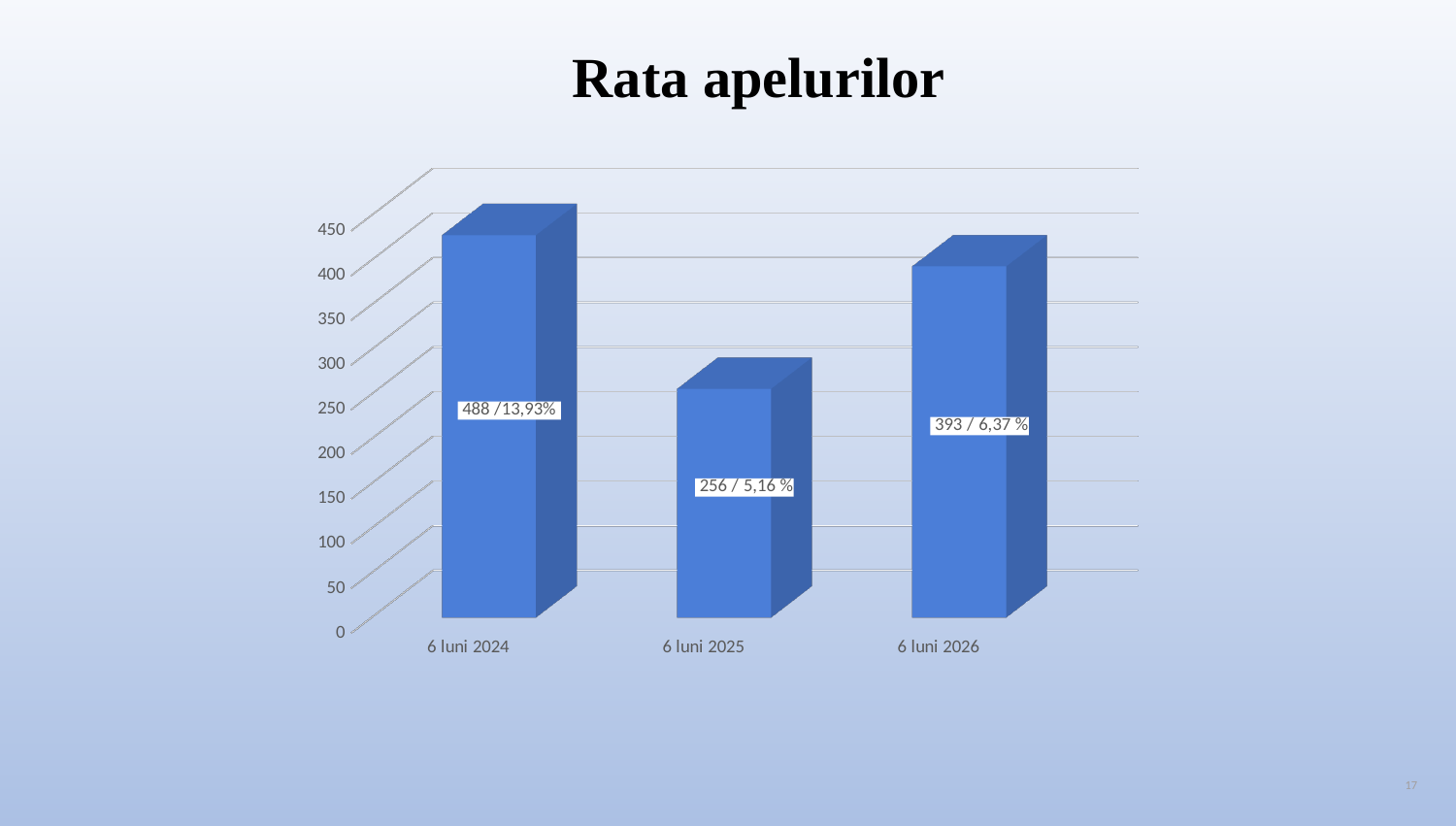
Which category has the lowest bar? 6 luni 2025 How many categories are shown on the x axis? 3 What kind of chart is shown on the slide? bar chart Is the value for 6 luni 2025 greater or less than 300? less What is the data label shown for 6 luni 2026? 393 / 6,37 % What is the title of the chart? Rata apelurilor Which category has the highest bar? 6 luni 2024 What is the difference between the count for 6 luni 2024 (488) and the count for 6 luni 2025 (256)? 232 Which is larger, the value for 6 luni 2026 or the value for 6 luni 2025? 6 luni 2026 What is the data label shown for 6 luni 2024? 488 /13,93% What is the difference between the count for 6 luni 2026 (393) and the count for 6 luni 2025 (256)? 137 What is the data label shown for 6 luni 2025? 256 / 5,16 %